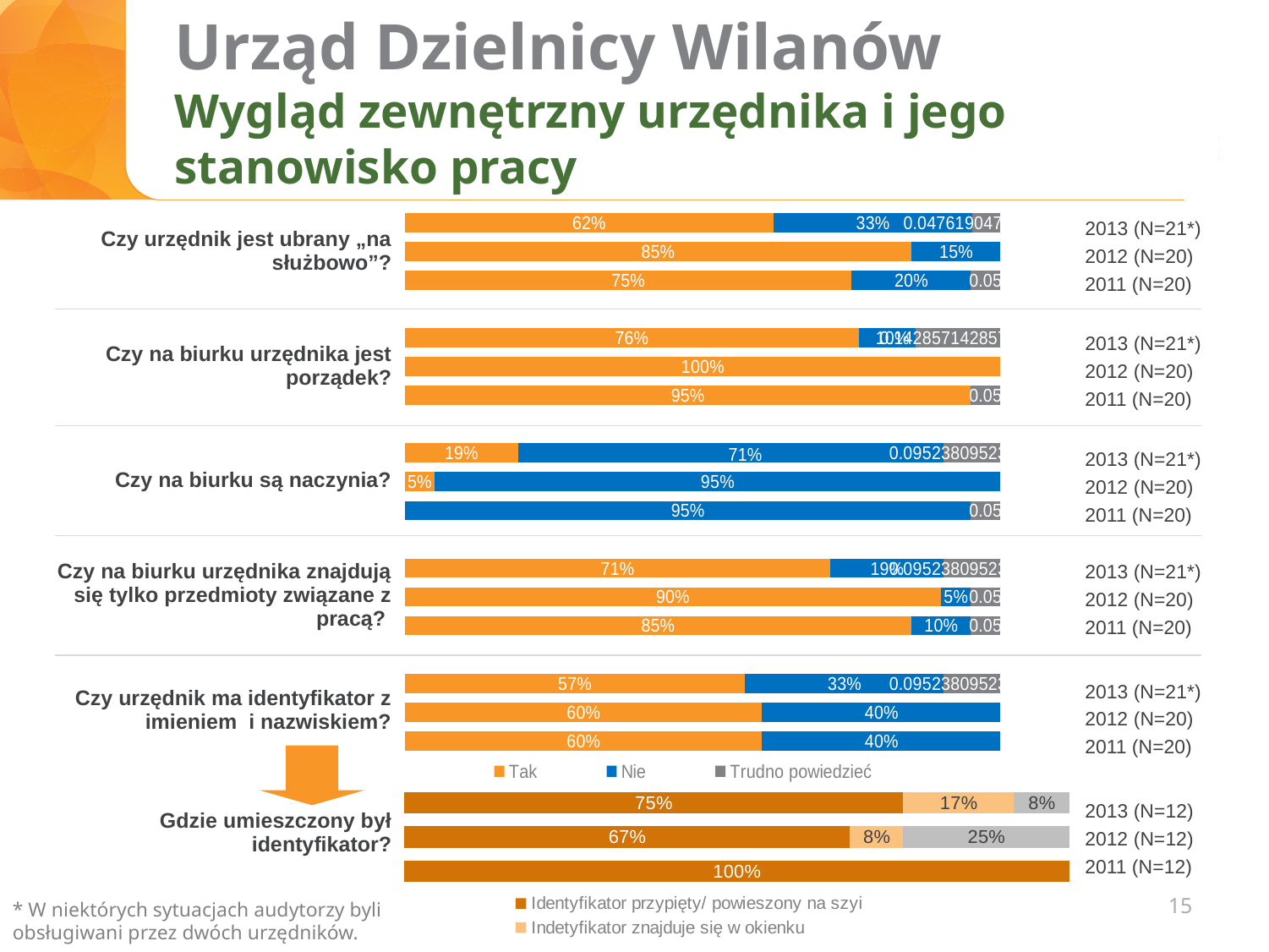
In the upper chart, for "Czy urzędnik ma identyfikator z imieniem i nazwiskiem?", which year has the lowest "Tak" share? 2013 (N=21*) How many series does the legend of the upper chart list? 3 In the upper chart, for "Czy na biurku są naczynia?", what percentage answered "Nie" in 2013 (N=21*)? 71% In the lower chart "Gdzie umieszczony był identyfikator?", what percentage was "Identyfikator przypięty/ powieszony na szyi" in 2012 (N=12)? 67% In the upper chart, what percentage answered "Nie" to "Czy urzędnik jest ubrany „na służbowo”?" in 2013 (N=21*)? 33% In the upper chart, what is the difference between the "Tak" shares for "Czy na biurku urzędnika jest porządek?" in 2012 and 2013? 24% In the upper chart, what percentage answered "Tak" to "Czy urzędnik jest ubrany „na służbowo”?" in 2012 (N=20)? 85% In the upper chart, what percentage answered "Tak" to "Czy na biurku urzędnika jest porządek?" in 2012 (N=20)? 100% In the lower chart "Gdzie umieszczony był identyfikator?", which year has the highest share for "Identyfikator przypięty/ powieszony na szyi"? 2011 (N=12) What type of chart is used on this slide? Bar chart In the upper chart, for "Czy na biurku urzędnika znajdują się tylko przedmioty związane z pracą?", is the "Tak" share larger in 2012 or in 2011? 2012 In the lower chart "Gdzie umieszczony był identyfikator?", what percentage was "Indetyfikator znajduje się w okienku" in 2013 (N=12)? 17%